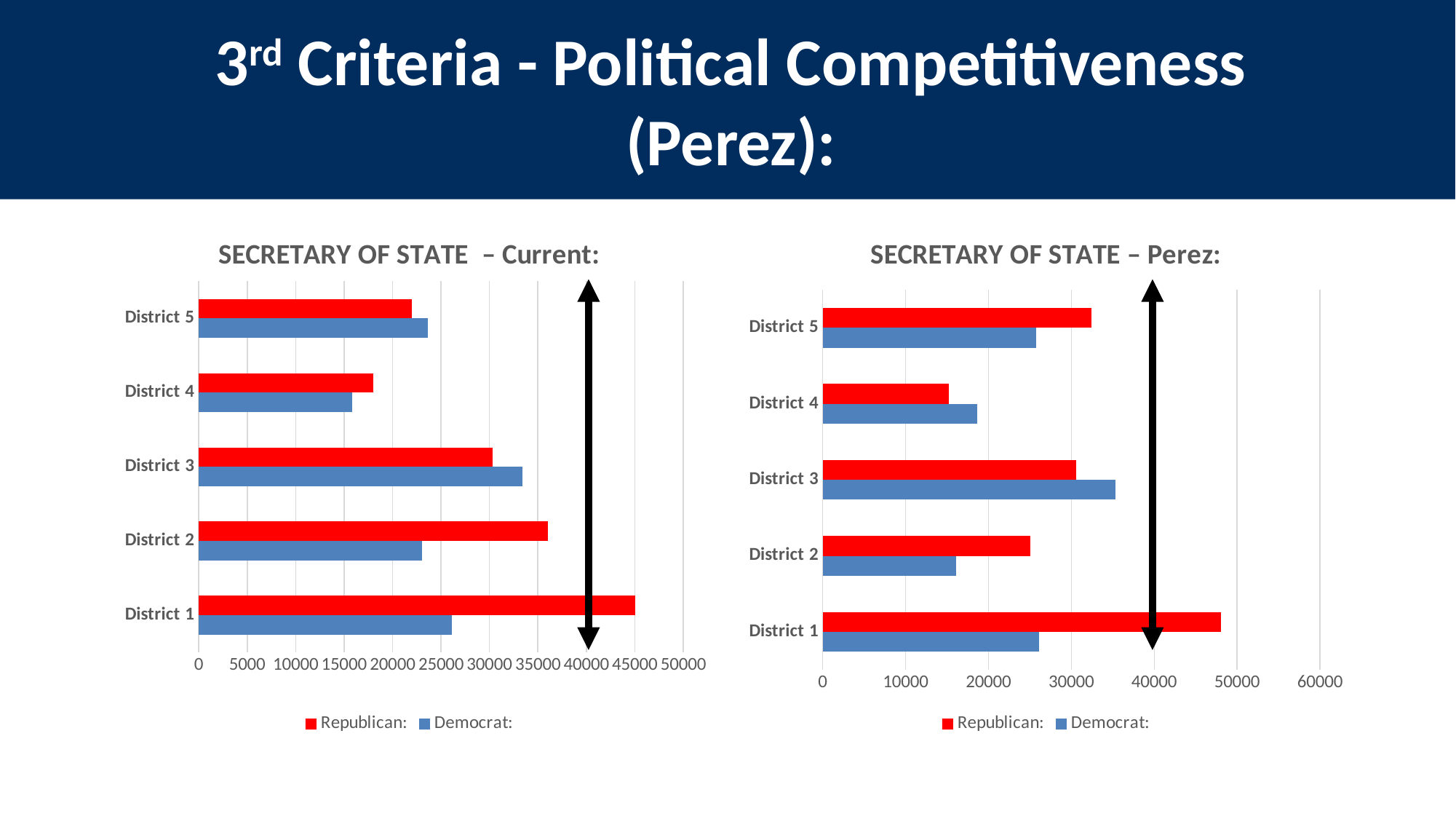
In the SECRETARY OF STATE – Current chart, which district has the lowest Democrat value? District 4 In the SECRETARY OF STATE – Current chart, which district has the highest Republican value? District 1 In the SECRETARY OF STATE – Perez chart, which district has the lowest Republican value? District 4 In the SECRETARY OF STATE – Current chart, is the Republican value for District 1 greater or less than 40000? greater In the SECRETARY OF STATE – Perez chart, is the Democrat value for District 4 greater or less than 20000? less What kind of chart is the SECRETARY OF STATE – Perez chart? bar chart In the SECRETARY OF STATE – Perez chart, is the Republican value for District 1 greater or less than 40000? greater In the SECRETARY OF STATE – Current chart, which is larger for District 2, the Republican or the Democrat value? Republican In the SECRETARY OF STATE – Current chart, how many series does the legend list? 2 In the SECRETARY OF STATE – Current chart, how many districts are shown? 5 In the SECRETARY OF STATE – Perez chart, which is larger for District 3, the Republican or the Democrat value? Democrat In the SECRETARY OF STATE – Perez chart, which district has the highest Democrat value? District 3